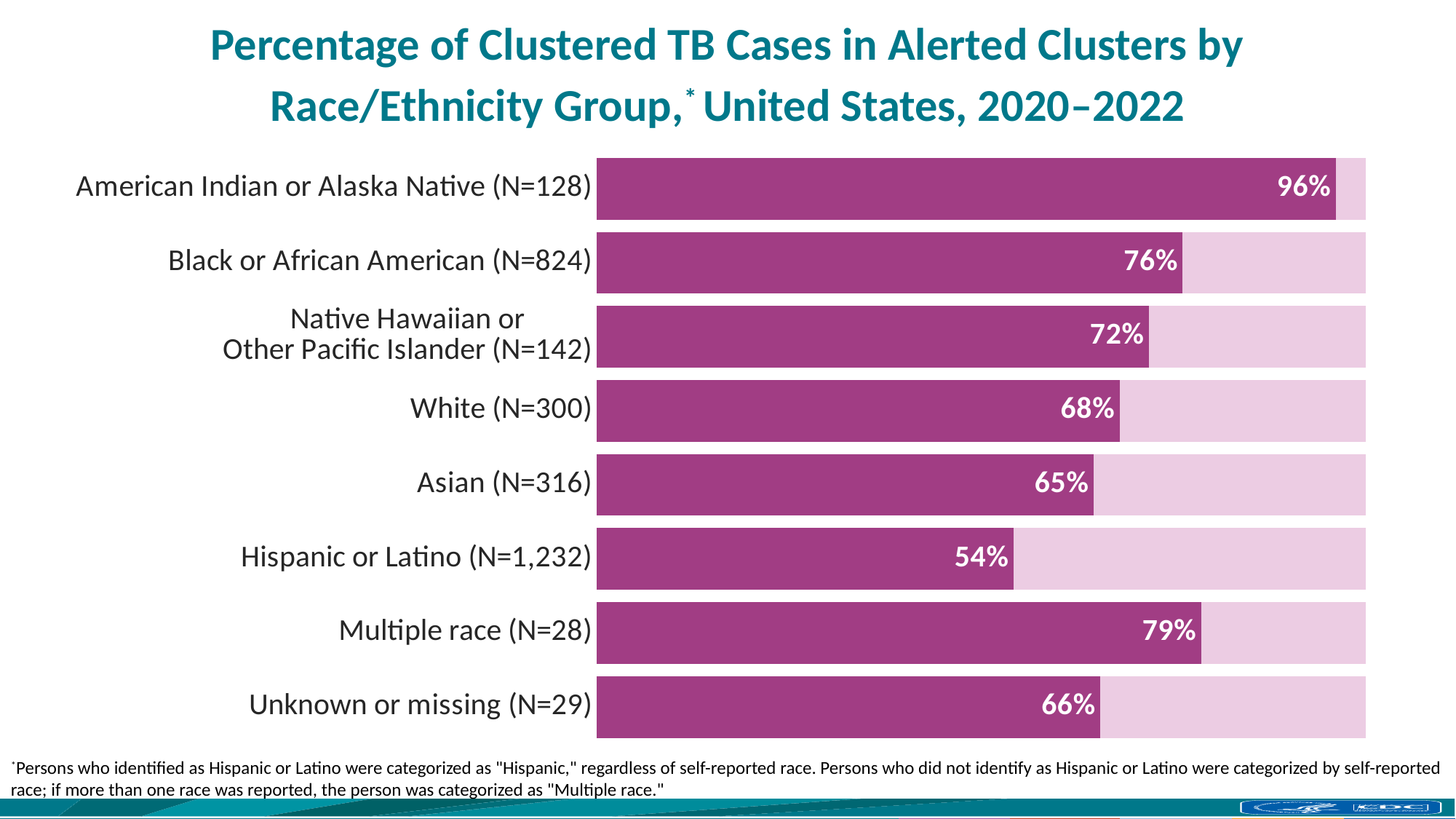
Which has a higher percentage, Asian or Unknown or missing? Unknown or missing What is the difference in percentage points between Black or African American and White? 8 Which race/ethnicity group has the lowest percentage? Hispanic or Latino How many race/ethnicity groups are shown in the chart? 8 What percentage of clustered TB cases were in alerted clusters for American Indian or Alaska Native persons? 96% What is the N value shown for the Black or African American group? 824 What is the value for Native Hawaiian or Other Pacific Islander? 72% What is the difference between the highest and lowest percentages shown? 42 What percentage is shown for Multiple race? 79% What kind of chart is shown on the slide? Bar chart Which race/ethnicity group has the highest percentage of clustered TB cases in alerted clusters? American Indian or Alaska Native What is the value shown for Hispanic or Latino? 54%